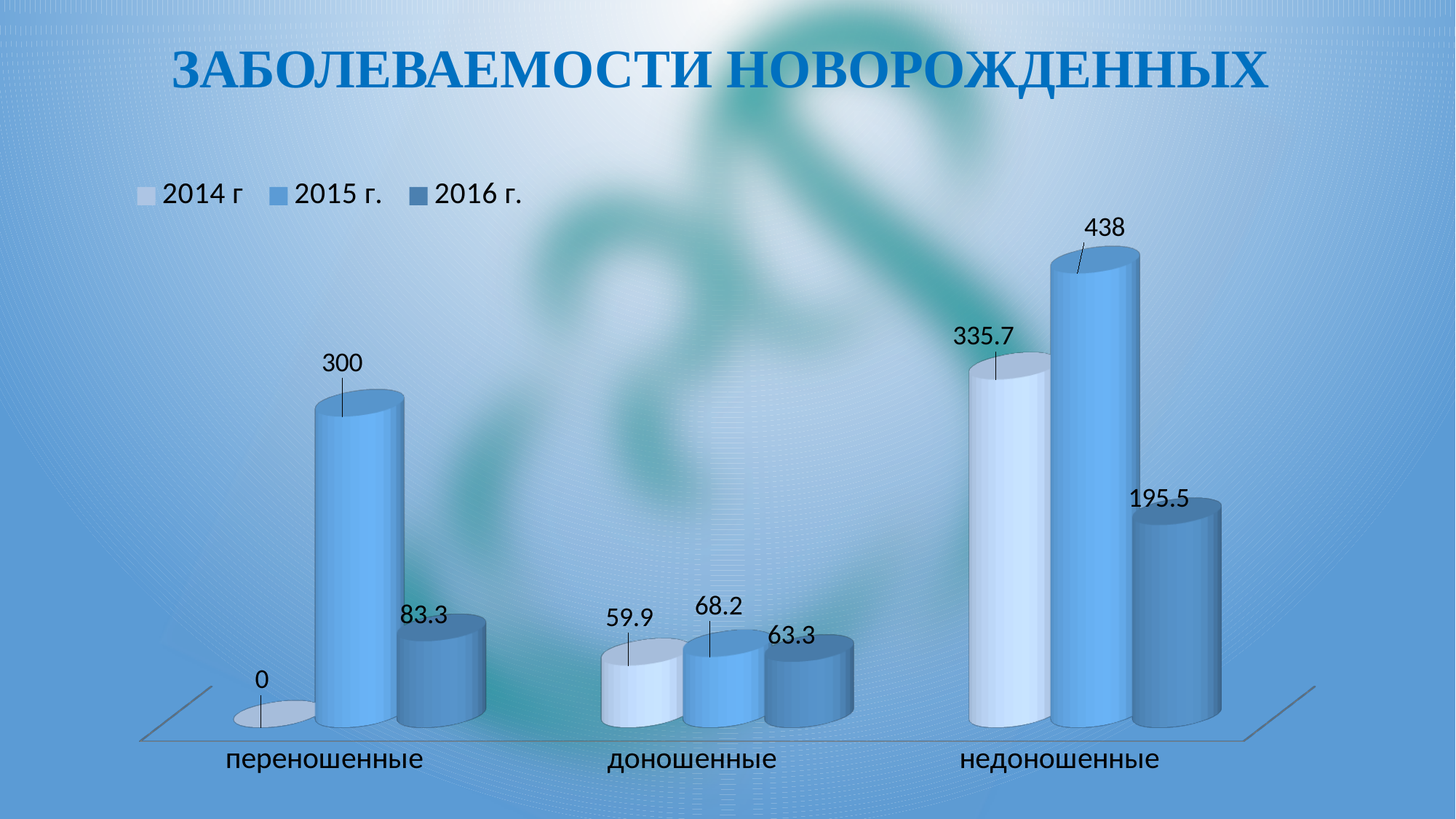
What kind of chart is shown on the slide? bar chart What is the value for переношенные in 2014 г? 0 What is the difference between the 2015 г. and 2016 г. values for недоношенные? 242.5 What is the difference between the 2015 г. and 2016 г. values for переношенные? 216.7 What is the value for доношенные in 2016 г.? 63.3 Which category has the highest value in 2016 г.? недоношенные How many categories are shown on the x axis? 3 Which category has the lowest value in 2015 г.? доношенные Which is larger: the 2014 г value for недоношенные or the 2015 г. value for переношенные? 2014 г value for недоношенные How many series does the legend list? 3 What is the value for недоношенные in 2015 г.? 438 What is the value for недоношенные in 2014 г? 335.7